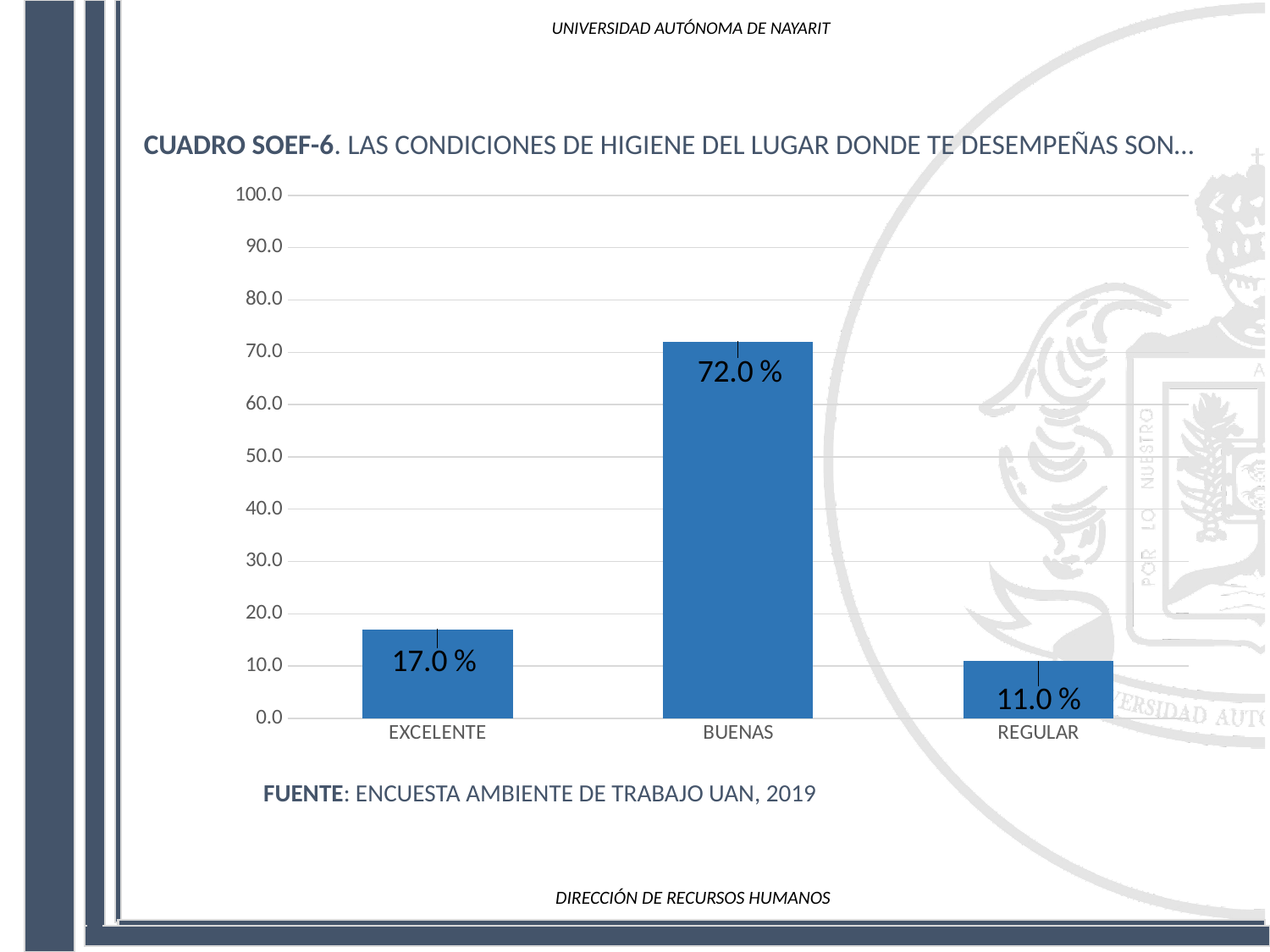
Which category has the lowest value? REGULAR What is the value for EXCELENTE? 17.0 % What is the difference between the values for EXCELENTE and REGULAR? 6.0 % Is the value for BUENAS greater or less than 50.0? greater Which is larger, the value for EXCELENTE or the value for REGULAR? EXCELENTE Which category has the highest value? BUENAS How many categories are shown on the x axis? 3 What kind of chart is shown on the slide? bar chart What is the value for BUENAS? 72.0 % What is the source cited below the chart? ENCUESTA AMBIENTE DE TRABAJO UAN, 2019 What is the difference between the values for BUENAS and EXCELENTE? 55.0 % What is the value for REGULAR? 11.0 %